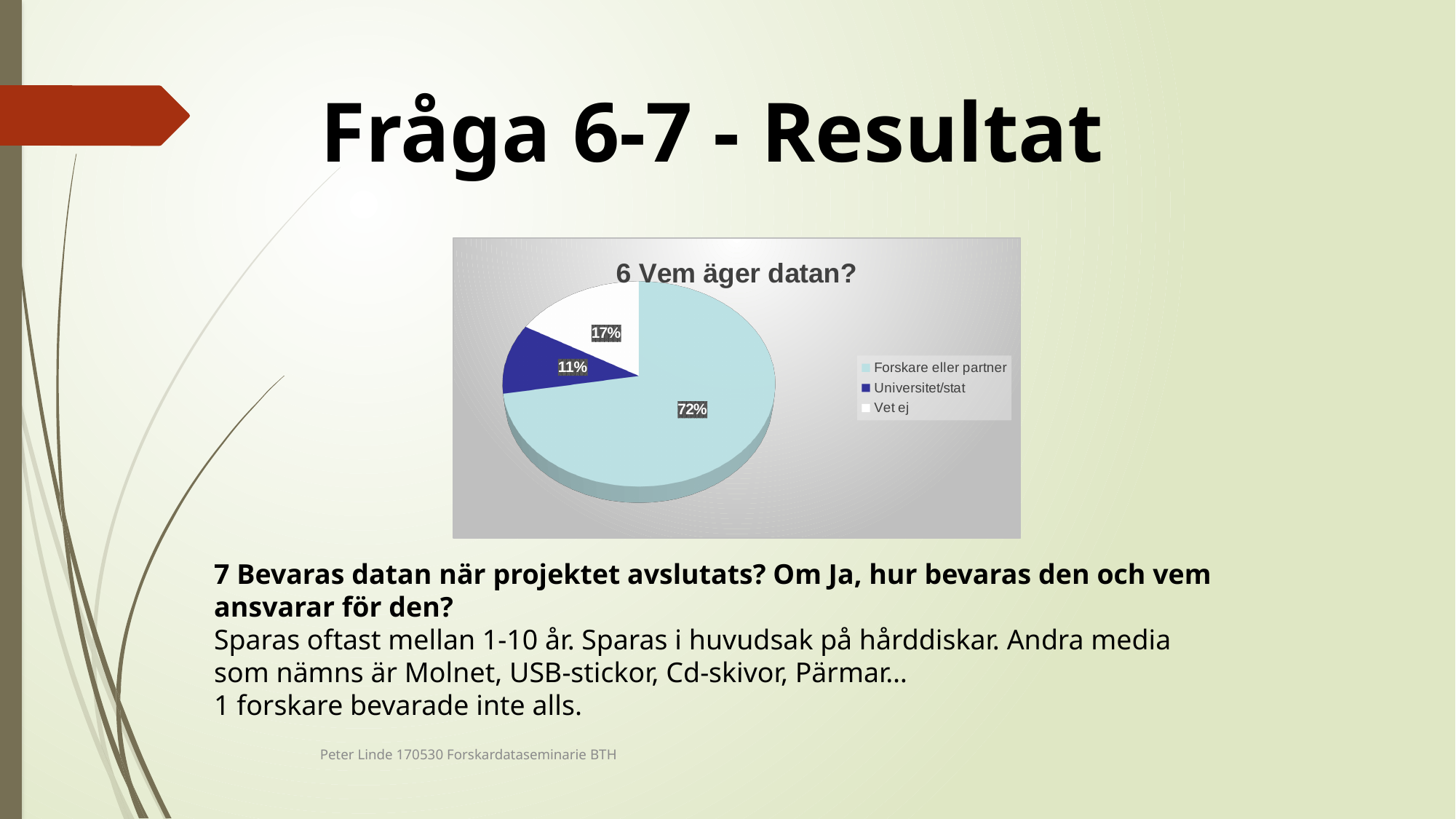
Which category has the largest slice of the pie? Forskare eller partner What share of the pie does 'Universitet/stat' have? 11% What is the title of the chart? 6 Vem äger datan? What share of the pie does 'Forskare eller partner' have? 72% What colour is the slice for 'Universitet/stat'? Dark blue Which is larger, the share for 'Vet ej' or the share for 'Universitet/stat'? Vet ej How many categories does the legend list? 3 What is the difference in percentage points between 'Forskare eller partner' and 'Vet ej'? 55 Which category has the smallest slice of the pie? Universitet/stat What kind of chart is shown on the slide? Pie chart What share of the pie does 'Vet ej' have? 17% What is the difference in percentage points between 'Vet ej' and 'Universitet/stat'? 6